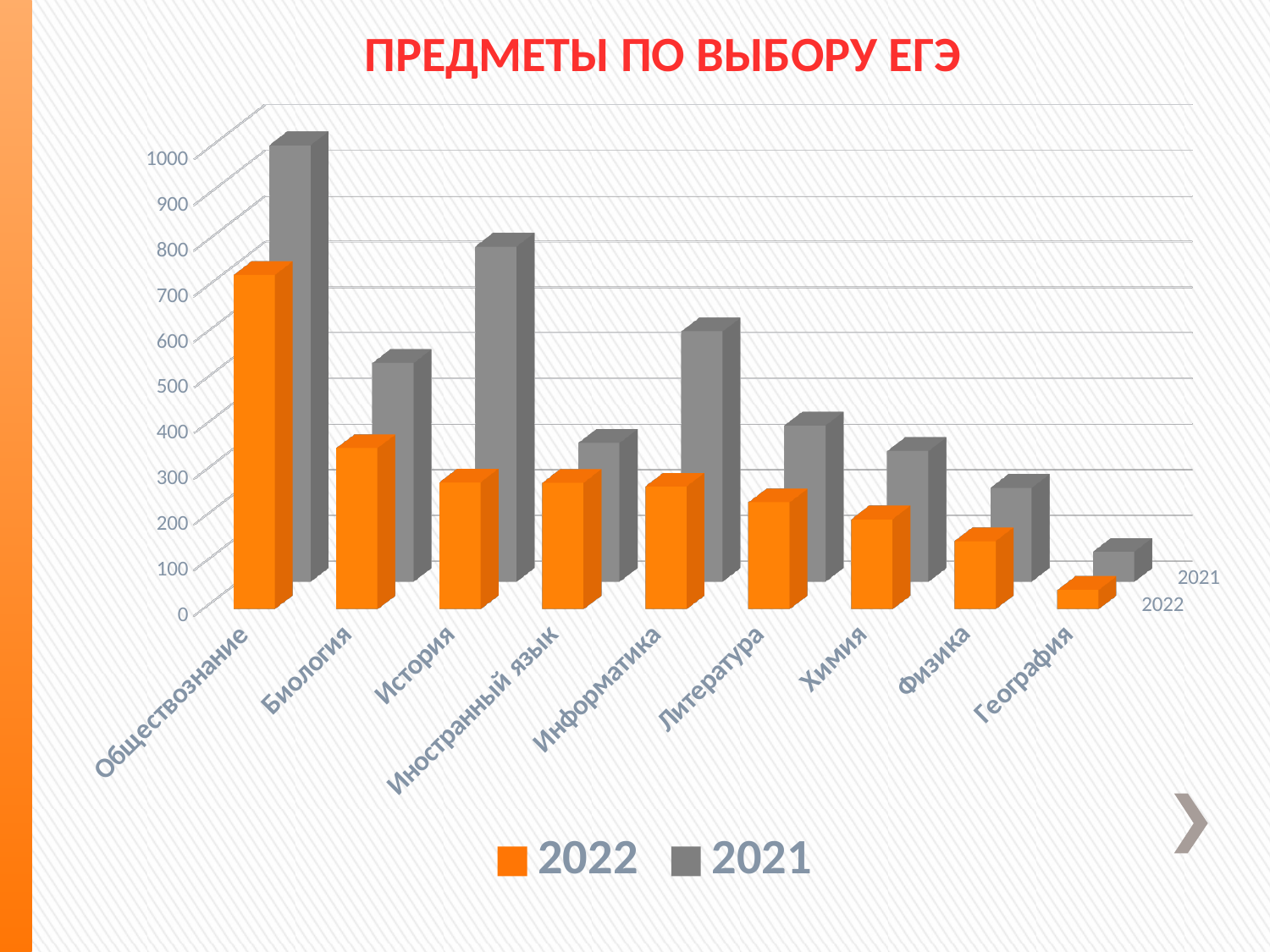
Is the 2021 value for Биология greater or less than 400? greater Is the 2021 value for История greater or less than 600? greater How many subjects (categories) are shown on the x axis? 9 Is the 2021 value for Обществознание greater or less than 900? greater For Обществознание, which year has the larger value, 2021 or 2022? 2021 Do the 2022 values generally rise or fall from Обществознание to География? fall Which subject has the highest value for 2021? Обществознание What kind of chart is shown on the slide? bar chart How many series does the legend list? 2 What is the title of the chart? ПРЕДМЕТЫ ПО ВЫБОРУ ЕГЭ Which subject has the lowest value for 2022? География